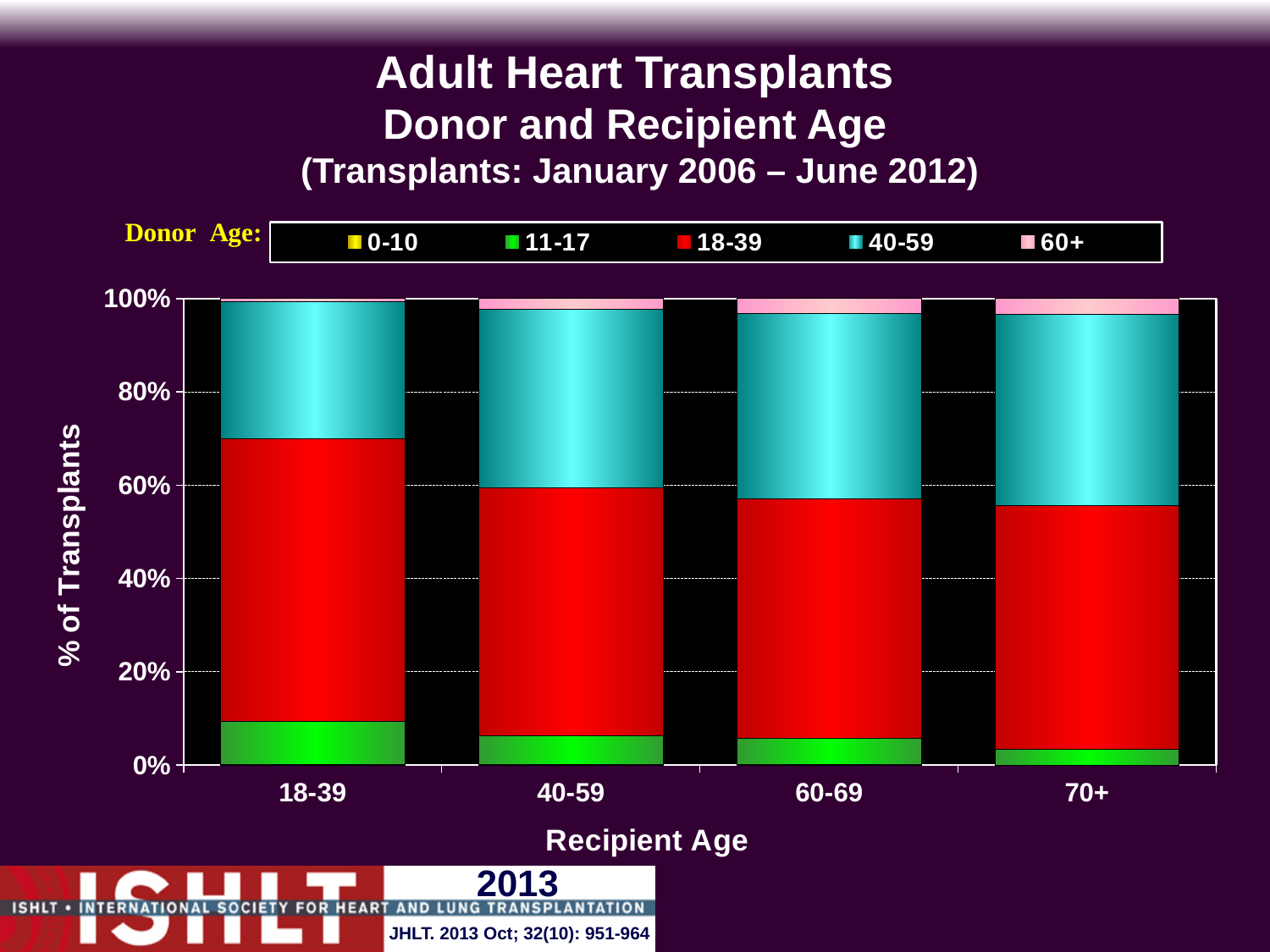
Which recipient age group has the smallest share of transplants from 11-17 donors? 70+ Which donor age group is shown in red in the legend? 18-39 How many recipient age categories are shown on the x axis? 4 Is the share of transplants from 40-59 donors for recipients aged 70+ greater or less than 60%? less Is the share of transplants from 11-17 donors for recipients aged 18-39 greater or less than 20%? less How many donor age series does the legend list? 5 What is the title of the chart? Adult Heart Transplants Donor and Recipient Age (Transplants: January 2006 – June 2012) What kind of chart is shown on the slide? stacked bar chart Is the share of transplants from 40-59 donors for recipients aged 18-39 greater or less than 20%? greater Which recipient age group has the largest share of transplants from 18-39 donors? 18-39 Which recipient age group has a larger share of transplants from 18-39 donors, 18-39 or 70+? 18-39